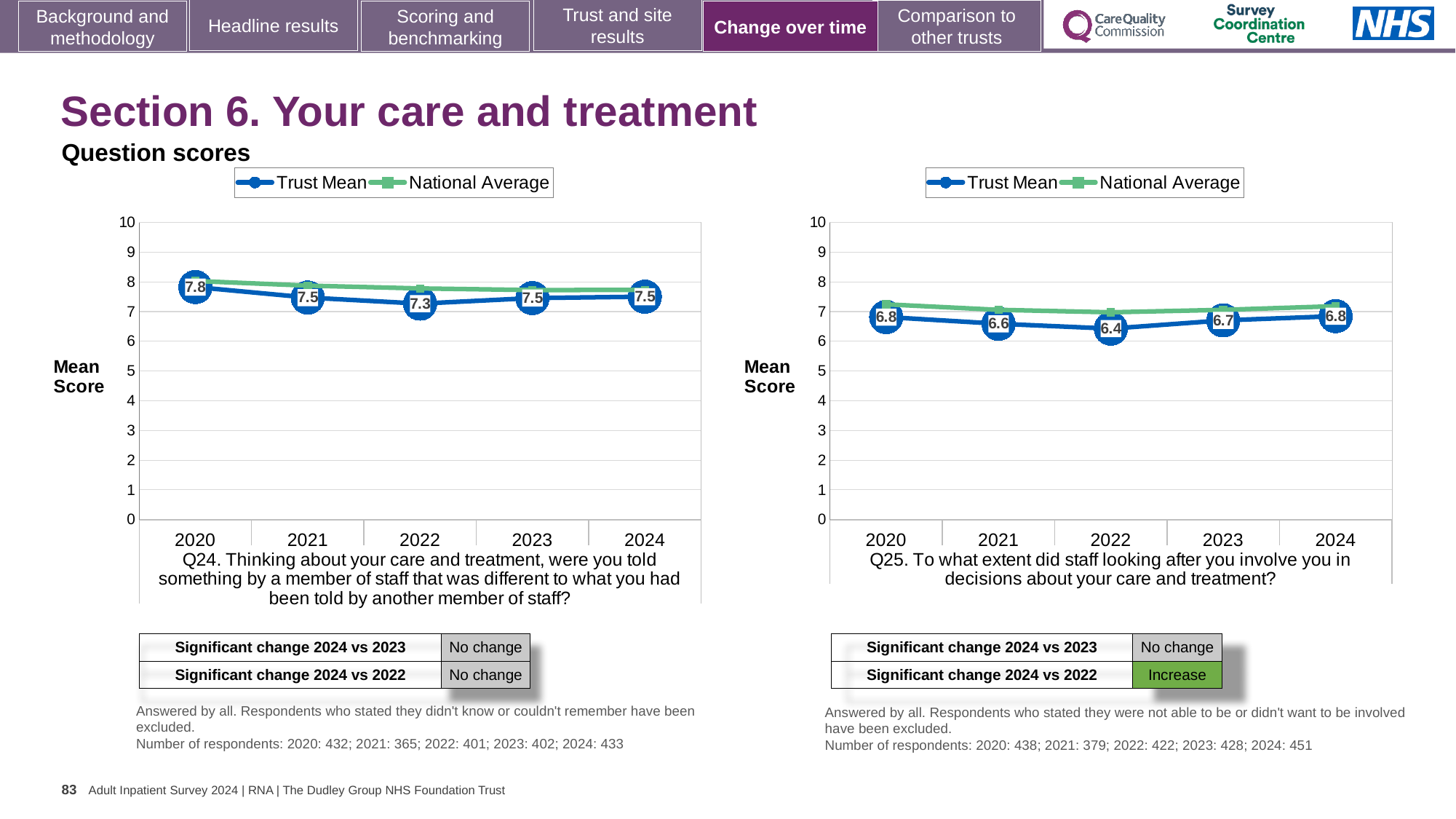
In the left chart (Q24), what is the Trust Mean score for 2022? 7.3 What type of chart is the left chart (Q24)? Line chart In the right chart (Q25), what is the Trust Mean score for 2021? 6.6 How many years are shown on the x axis of the left chart (Q24)? 5 In the right chart (Q25), what is the difference between the Trust Mean scores for 2024 and 2022? 0.4 In the left chart (Q24), what is the difference between the Trust Mean scores for 2020 and 2022? 0.5 In the right chart (Q25), what is the Trust Mean score for 2024? 6.8 In the right chart (Q25), which year has the lowest Trust Mean score? 2022 How many series does the legend of the right chart (Q25) list? 2 In the left chart (Q24), what is the Trust Mean score for 2020? 7.8 In the left chart (Q24), which year has the highest Trust Mean score? 2020 In the right chart (Q25), is the Trust Mean score for 2023 greater or less than 6? greater